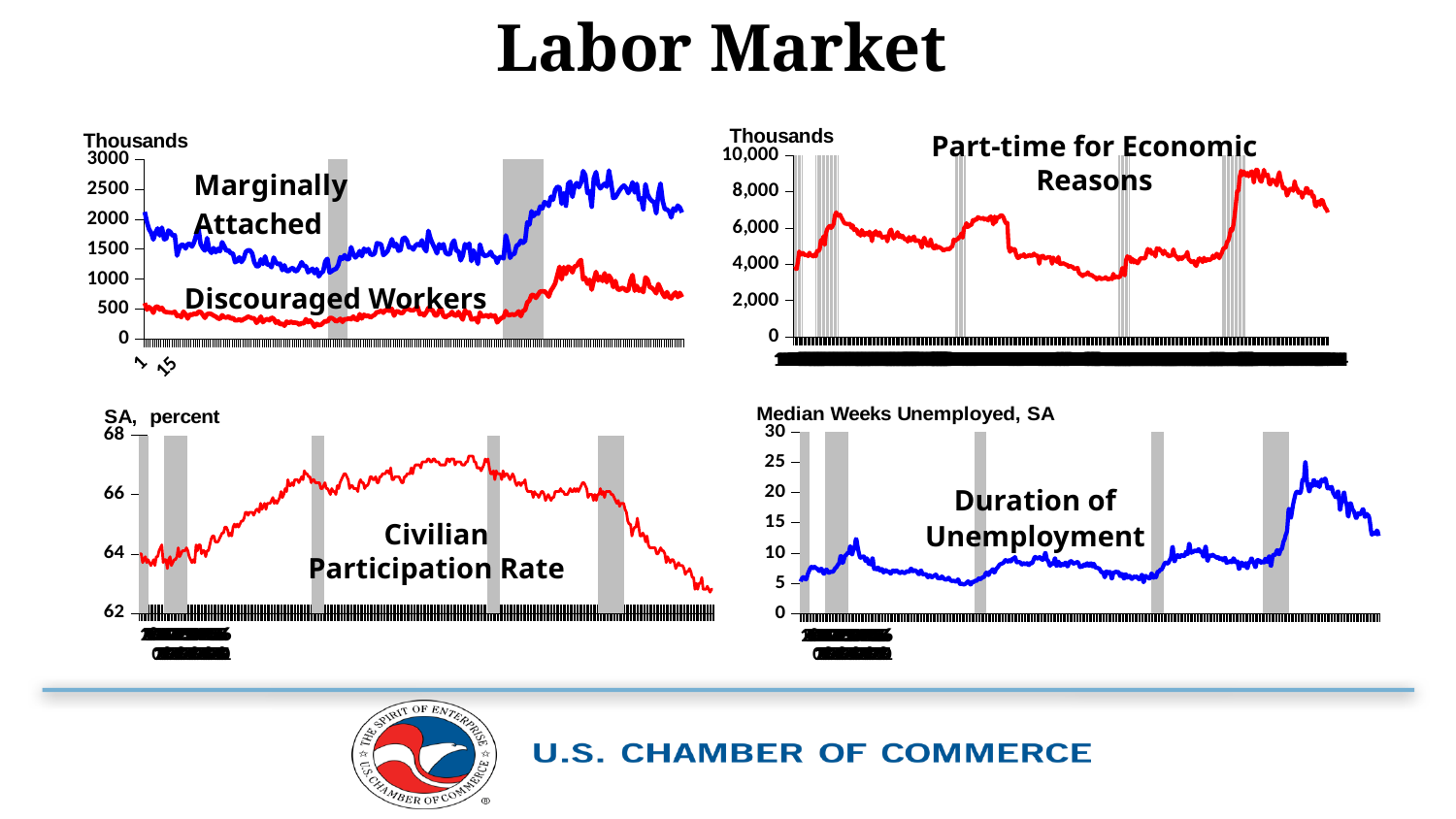
In the top-left chart, which series is higher throughout, Marginally Attached or Discouraged Workers? Marginally Attached In the Civilian Participation Rate chart, is the final value at the right end greater or less than 64? less What unit is shown on the y axis of the Part-time for Economic Reasons chart? Thousands In the top-left chart, is the highest value of Discouraged Workers greater or less than 1500? less What kind of chart is the Civilian Participation Rate chart? line chart How many charts are shown on the slide? 4 In the Part-time for Economic Reasons chart, is the peak value greater or less than 8,000? greater In the Civilian Participation Rate chart, do values rise or fall over the last portion of the x axis? fall In the top-left chart, how many series are plotted? 2